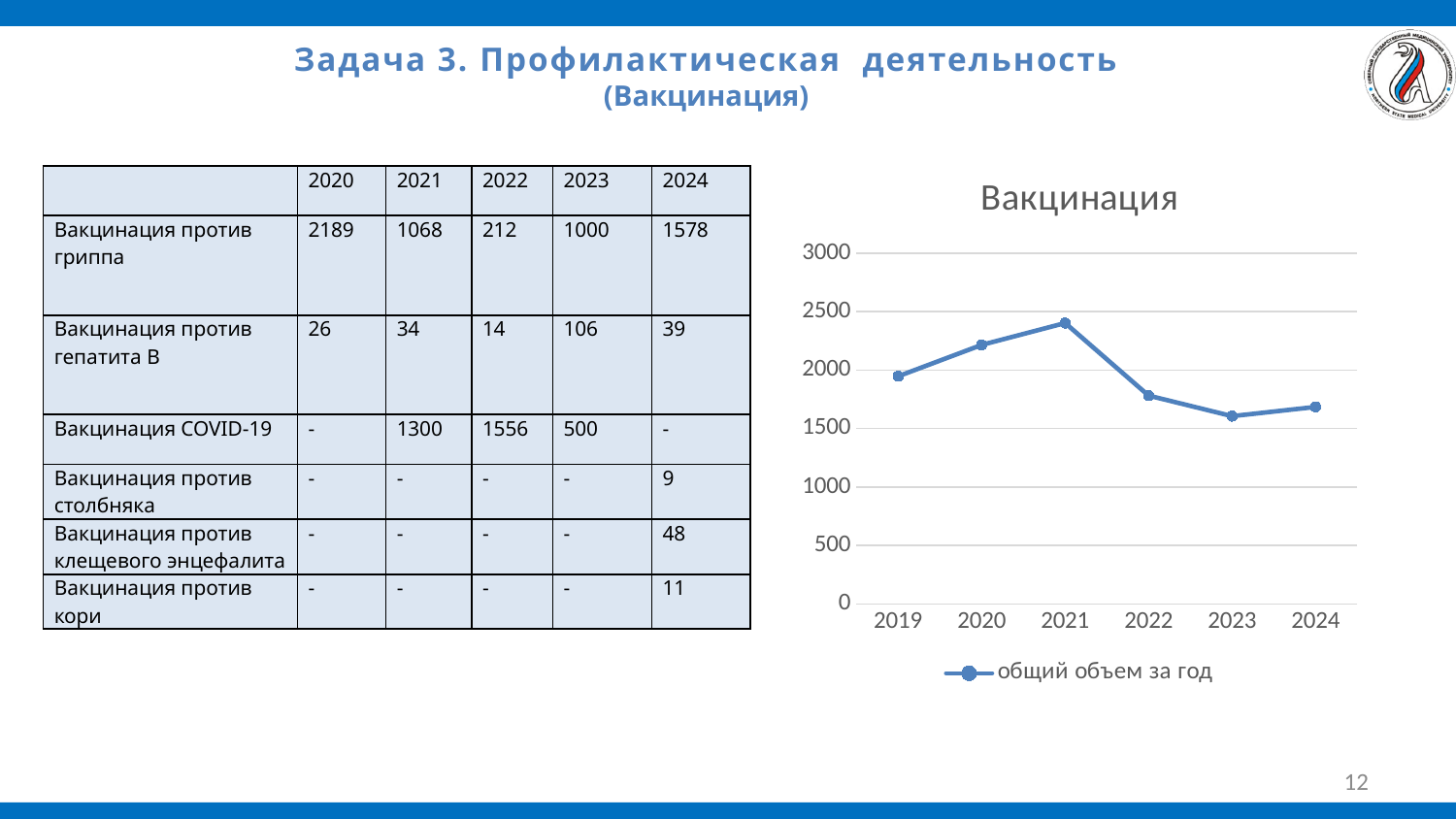
Is the value for 2022 greater or less than 2000? less Which is larger, the value for 2020 or the value for 2022? 2020 What is the name of the series shown in the chart legend? общий объем за год How many series does the chart legend list? 1 What is the title of the chart? Вакцинация Which year has the highest value in the chart? 2021 Is the value for 2020 greater or less than 2000? greater Do the values rise or fall from 2021 to 2023? fall Is the value for 2024 greater or less than 2000? less How many years are plotted on the x axis of the chart? 6 What kind of chart is shown on the slide? line chart